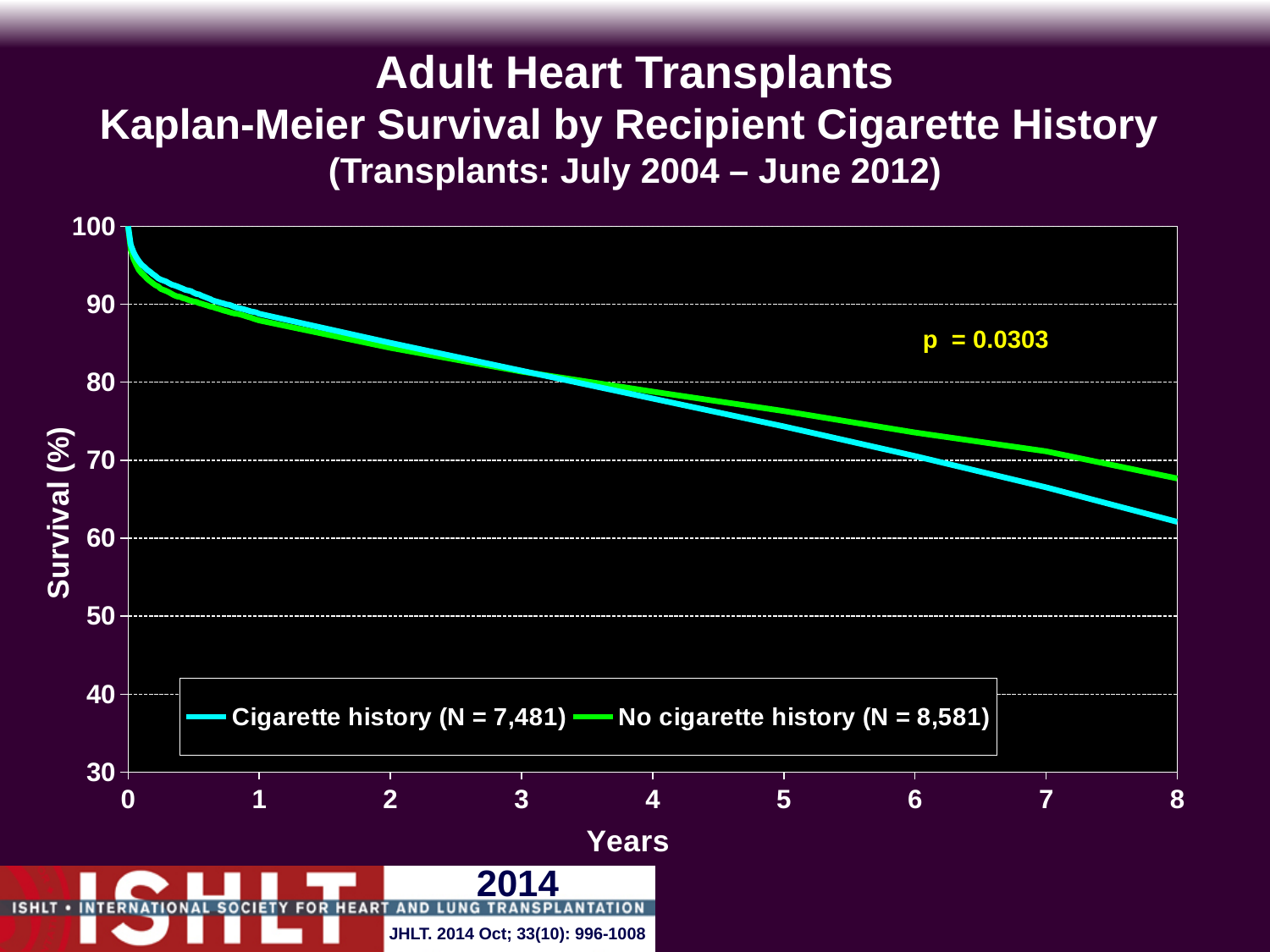
Is the survival for No cigarette history at 8 years greater or less than 60? greater Is the survival for No cigarette history at 2 years greater or less than 90? less Is the survival for Cigarette history at 5 years greater or less than 80? less What p-value is printed on the chart? p = 0.0303 Do the survival curves rise or fall as years increase? fall At 6 years, which group has lower survival: Cigarette history or No cigarette history? Cigarette history At 8 years, which group has higher survival: Cigarette history or No cigarette history? No cigarette history How many series does the legend list? 2 What kind of chart is shown on the slide? line chart According to the legend, what is N for the Cigarette history group? 7,481